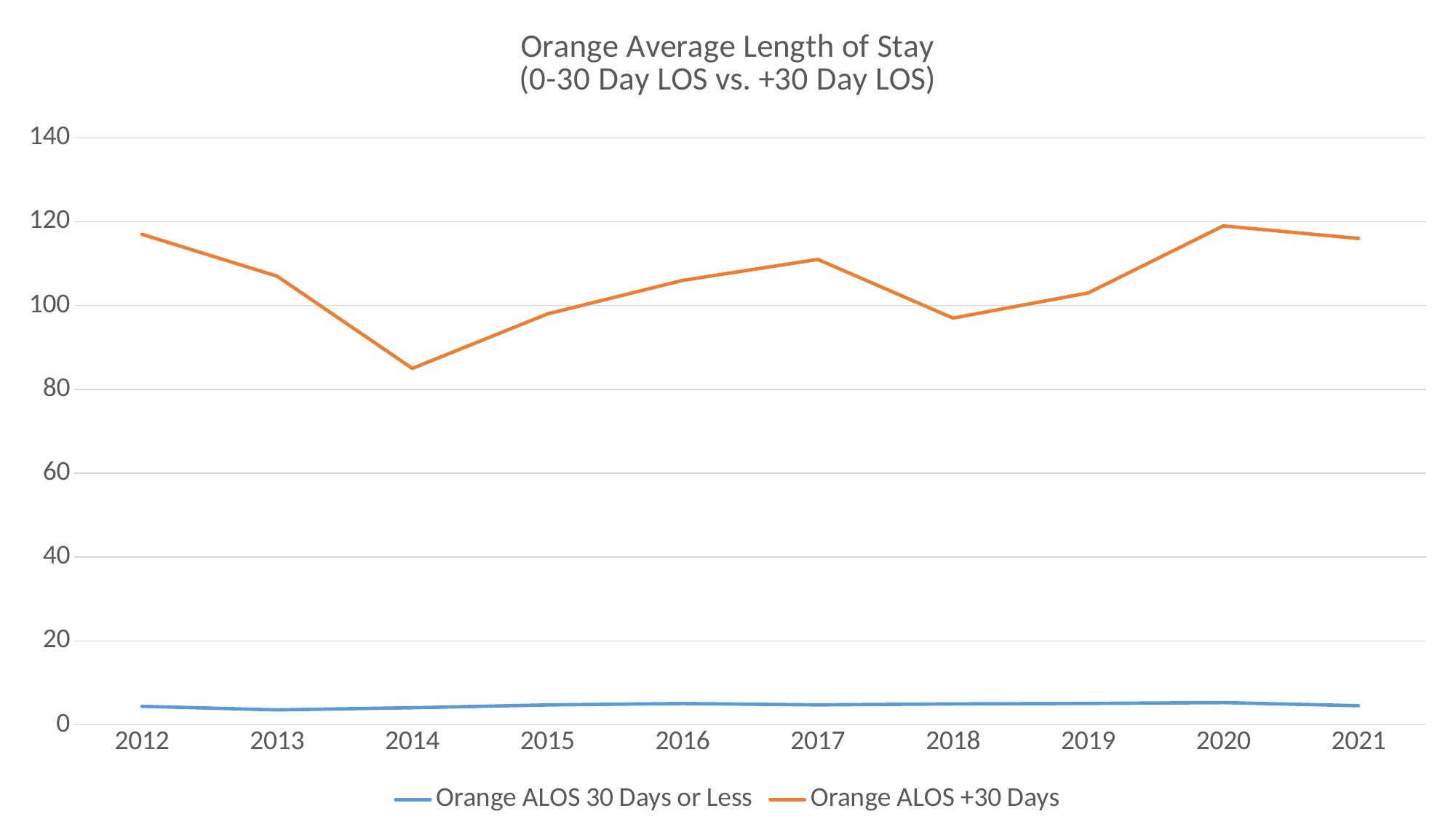
Is the Orange ALOS 30 Days or Less value for 2016 greater or less than 20? less Is the Orange ALOS +30 Days value for 2012 greater or less than 100? greater Which is larger in 2017: Orange ALOS 30 Days or Less or Orange ALOS +30 Days? Orange ALOS +30 Days How many series does the legend list? 2 What kind of chart is shown on the slide? Line chart What is the title of the chart? Orange Average Length of Stay (0-30 Day LOS vs. +30 Day LOS) Is the Orange ALOS +30 Days value for 2014 greater or less than 100? less Does the Orange ALOS +30 Days line rise or fall from 2012 to 2014? Fall In which year is the Orange ALOS +30 Days value lowest? 2014 Which year has the larger Orange ALOS +30 Days value, 2014 or 2017? 2017 How many years are plotted along the x axis? 10